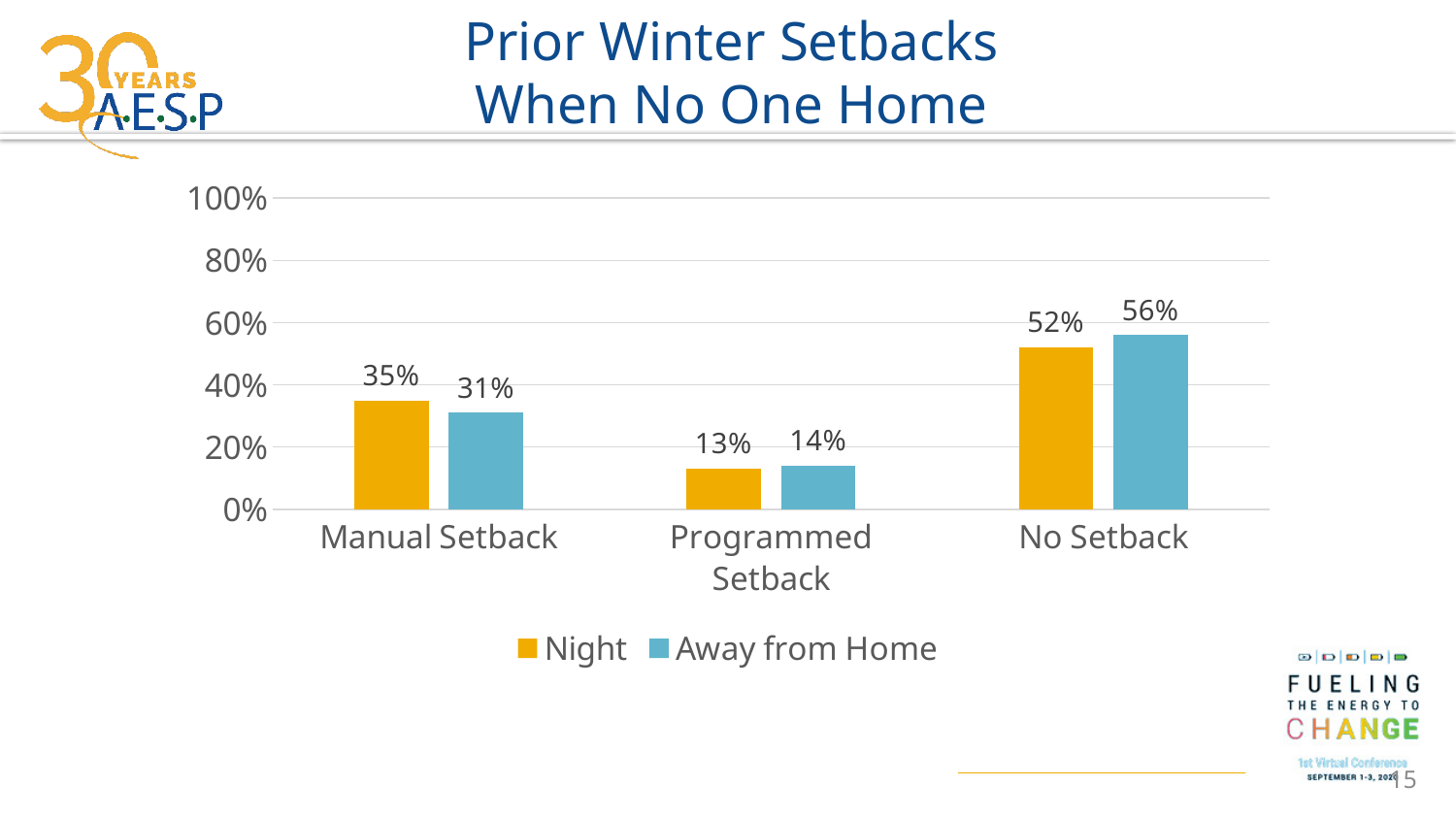
What is the difference between the Night and Away from Home values for No Setback? 4% What is the Away from Home value for No Setback? 56% Which colour represents the Away from Home series? Blue For Manual Setback, which series has the larger value, Night or Away from Home? Night How many categories are shown on the x axis? 3 What is the Night value for Manual Setback? 35% What is the difference between the Night values for Manual Setback and Programmed Setback? 22% What kind of chart is shown on the slide? Bar chart How many series does the legend list? 2 What is the Away from Home value for Programmed Setback? 14% Which category has the highest Night value? No Setback Which category has the lowest Away from Home value? Programmed Setback